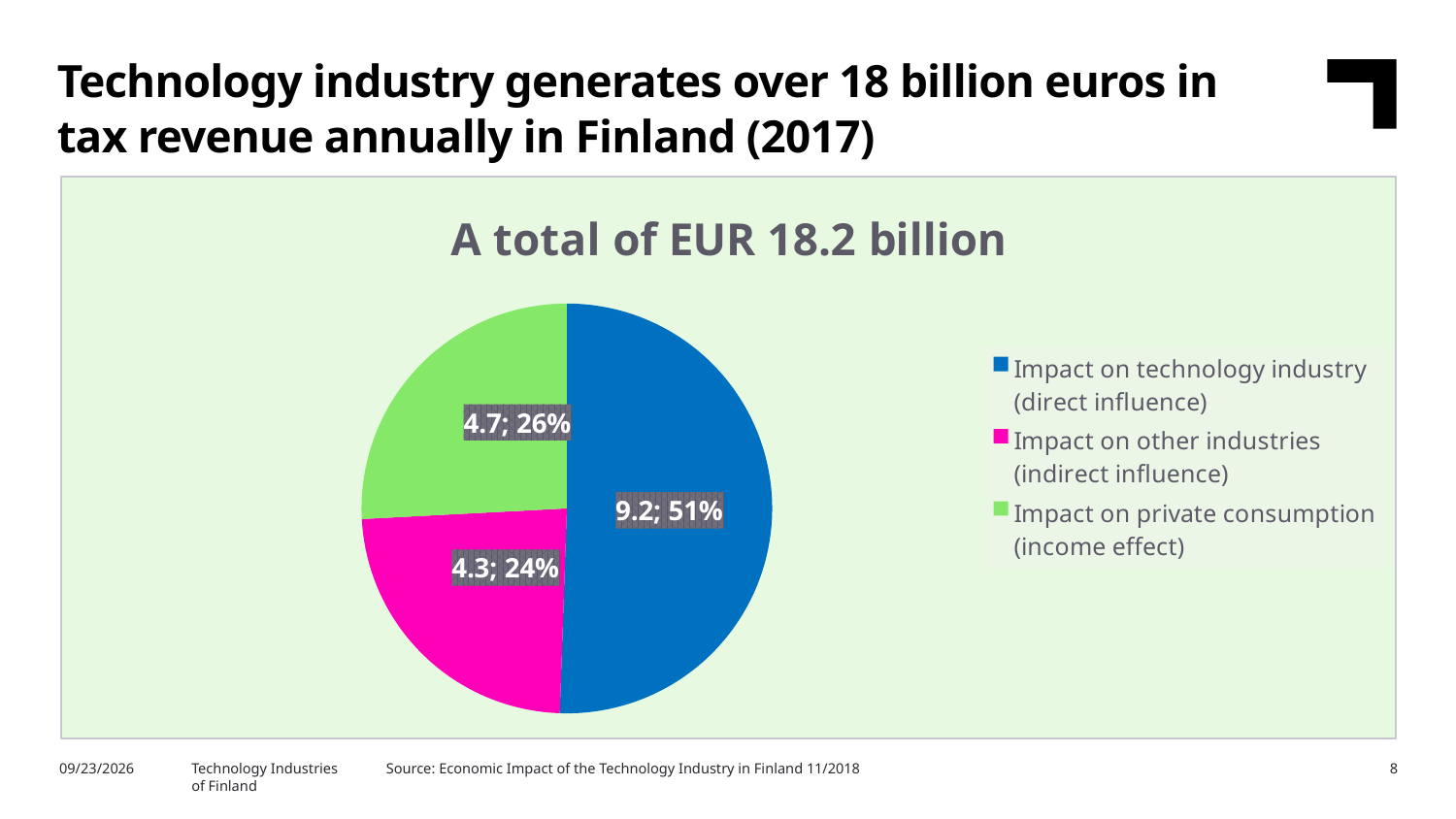
What share of the pie does Impact on technology industry (direct influence) represent? 51% What value is shown for Impact on other industries (indirect influence)? 4.3 How many entries does the legend list? 3 Which slice is the smallest? Impact on other industries (indirect influence) Which slice is the largest? Impact on technology industry (direct influence) What is the chart's title? A total of EUR 18.2 billion What value is shown for Impact on private consumption (income effect)? 4.7 What share of the pie does Impact on private consumption (income effect) represent? 26% How many slices does the pie chart have? 3 What is the difference between the values for Impact on technology industry (direct influence) and Impact on private consumption (income effect)? 4.5 What kind of chart is shown on the slide? pie chart What value is shown for Impact on technology industry (direct influence)? 9.2